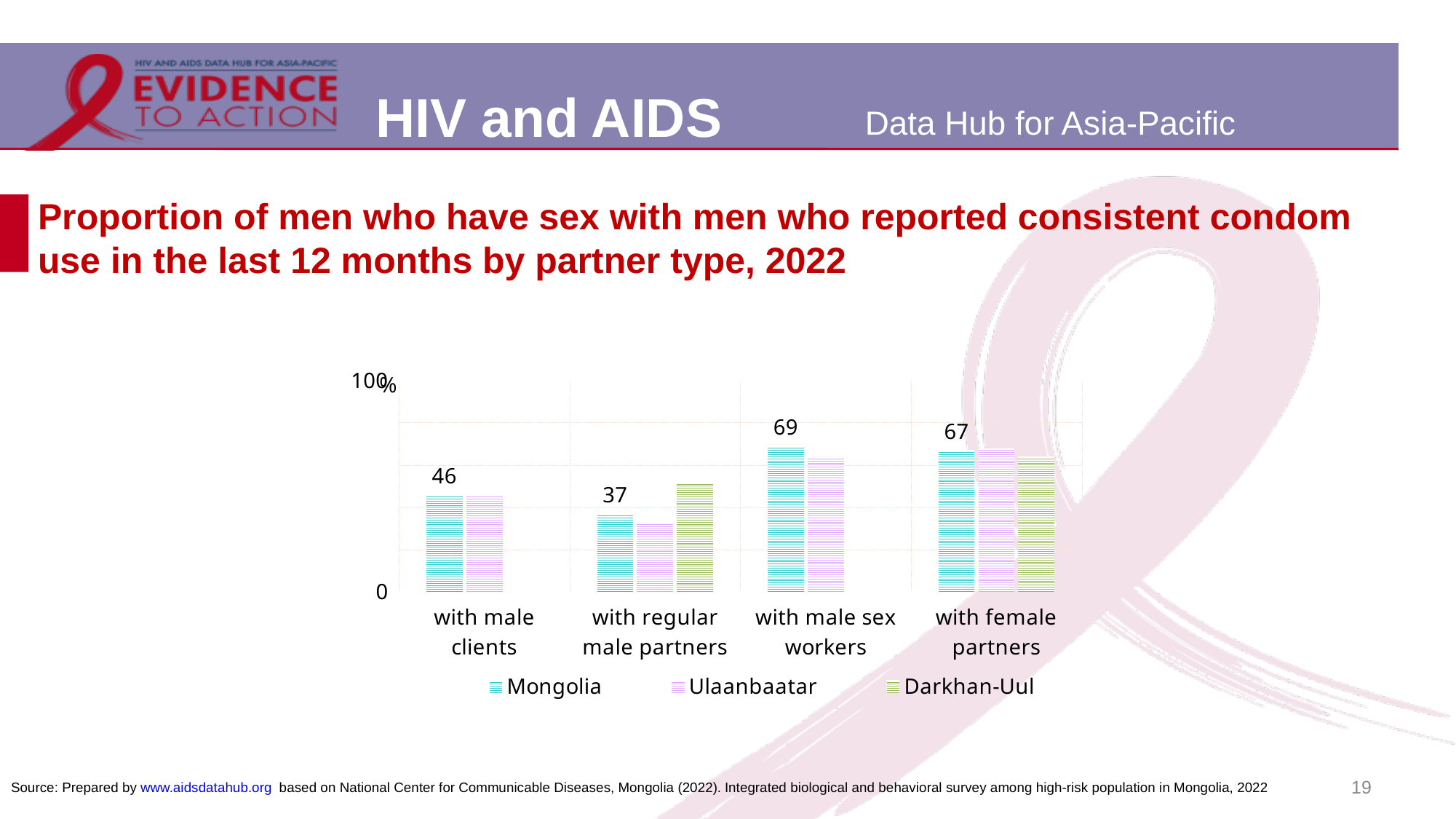
What is the value for Mongolia for 'with regular male partners'? 37 What is the value for Mongolia for 'with male clients'? 46 For the Mongolia series, which partner type has the highest value? with male sex workers For the Mongolia series, which partner type has the lowest value? with regular male partners What is the value for Mongolia for 'with female partners'? 67 For 'with regular male partners', which is larger: the Ulaanbaatar bar or the Darkhan-Uul bar? Darkhan-Uul What is the difference between the Mongolia values for 'with male clients' and 'with regular male partners'? 9 For Mongolia, which is larger: the value for 'with male clients' or 'with female partners'? with female partners How many series does the legend list? 3 What is the difference between the Mongolia values for 'with male sex workers' and 'with regular male partners'? 32 How many partner-type categories are shown on the x axis? 4 What is the value for Mongolia for 'with male sex workers'? 69